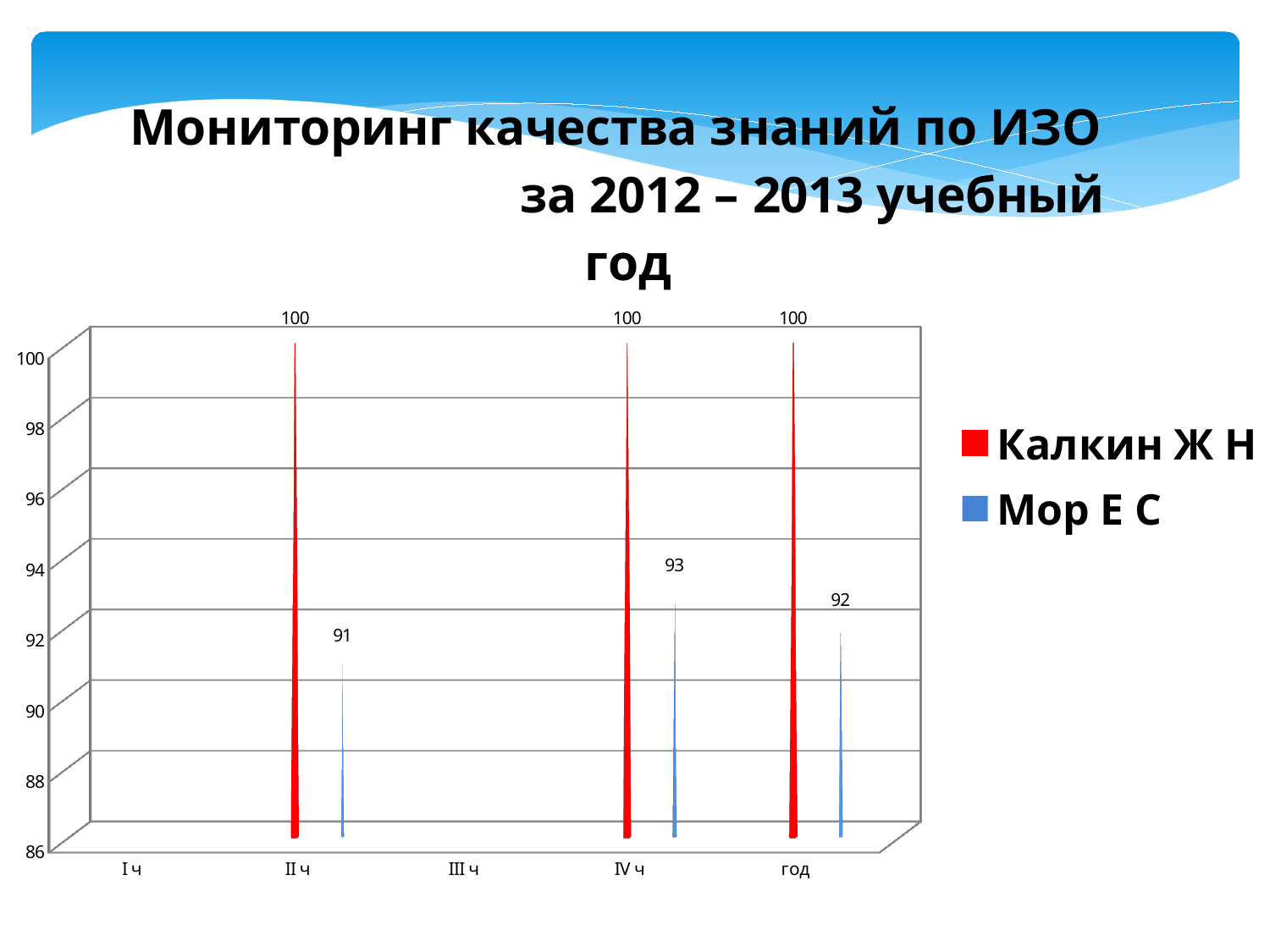
What is the difference between Калкин Ж Н and Мор Е С in год? 8 In which category is the value for Мор Е С lowest? II ч What is the value for Калкин Ж Н in II ч? 100 How many series does the legend list? 2 What is the value for Мор Е С in II ч? 91 What kind of chart is shown on the slide? Bar chart How many categories are shown on the x axis? 5 What is the difference between Калкин Ж Н and Мор Е С in IV ч? 7 Which series has the larger value in II ч, Калкин Ж Н or Мор Е С? Калкин Ж Н What is the value for Мор Е С in год? 92 In which category is the value for Мор Е С highest? IV ч What is the value for Мор Е С in IV ч? 93